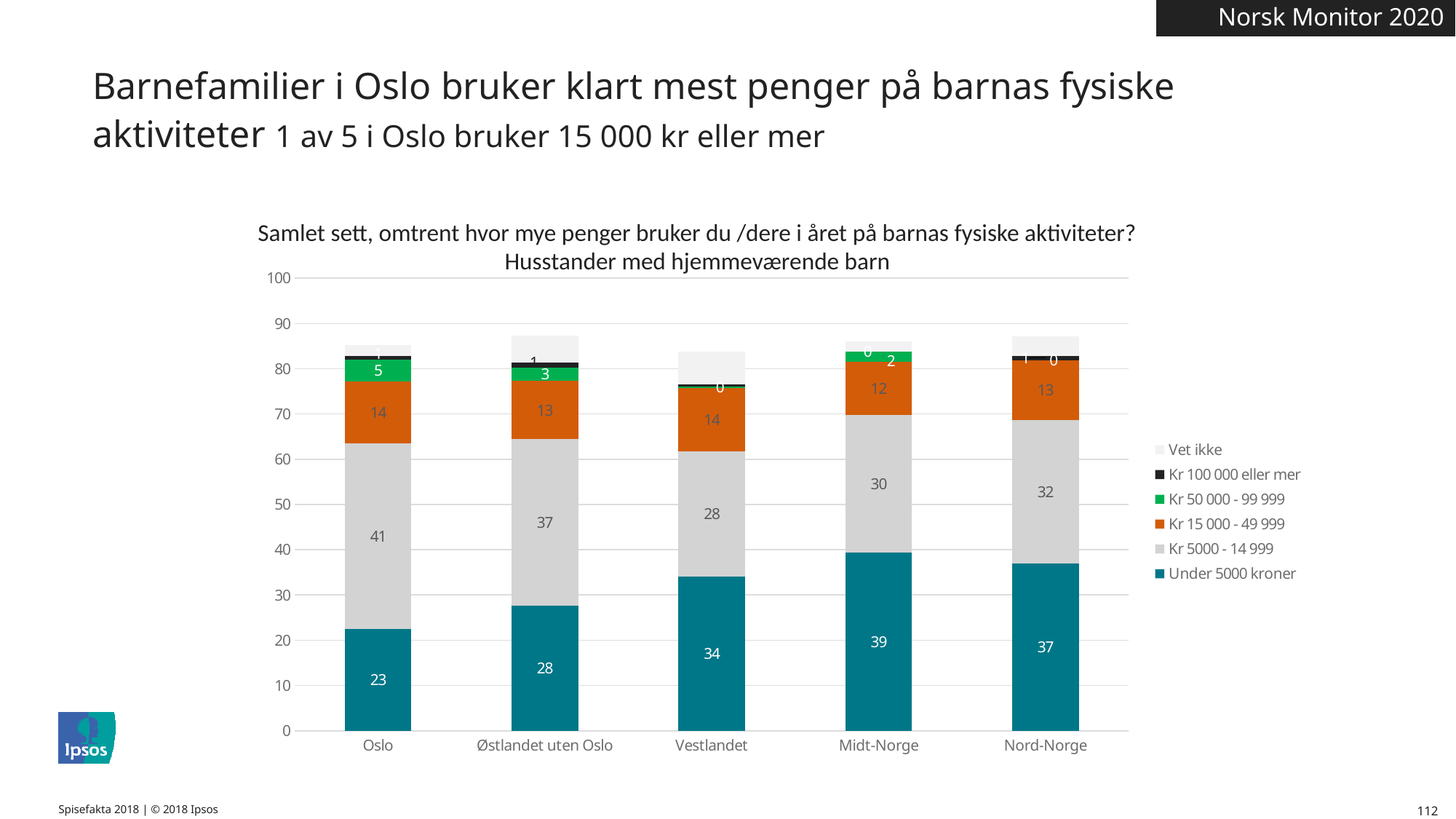
How many regions are shown on the x axis? 5 Is the top of the stacked bar for Østlandet uten Oslo greater or less than 80? greater What is the value for Østlandet uten Oslo in the 'Kr 50 000 - 99 999' series? 3 What is the value for Midt-Norge in the 'Kr 15 000 - 49 999' series? 12 What is the difference between Oslo and Vestlandet in the 'Under 5000 kroner' series? 11 Which region has the lowest value in the 'Kr 5000 - 14 999' series? Vestlandet What kind of chart is shown on the slide? Stacked bar chart Which is larger in the 'Kr 5000 - 14 999' series: Oslo or Nord-Norge? Oslo What is the value for Vestlandet in the 'Kr 5000 - 14 999' series? 28 Which region has the highest value in the 'Under 5000 kroner' series? Midt-Norge How many series does the legend list? 6 What is the value for Oslo in the 'Under 5000 kroner' series? 23